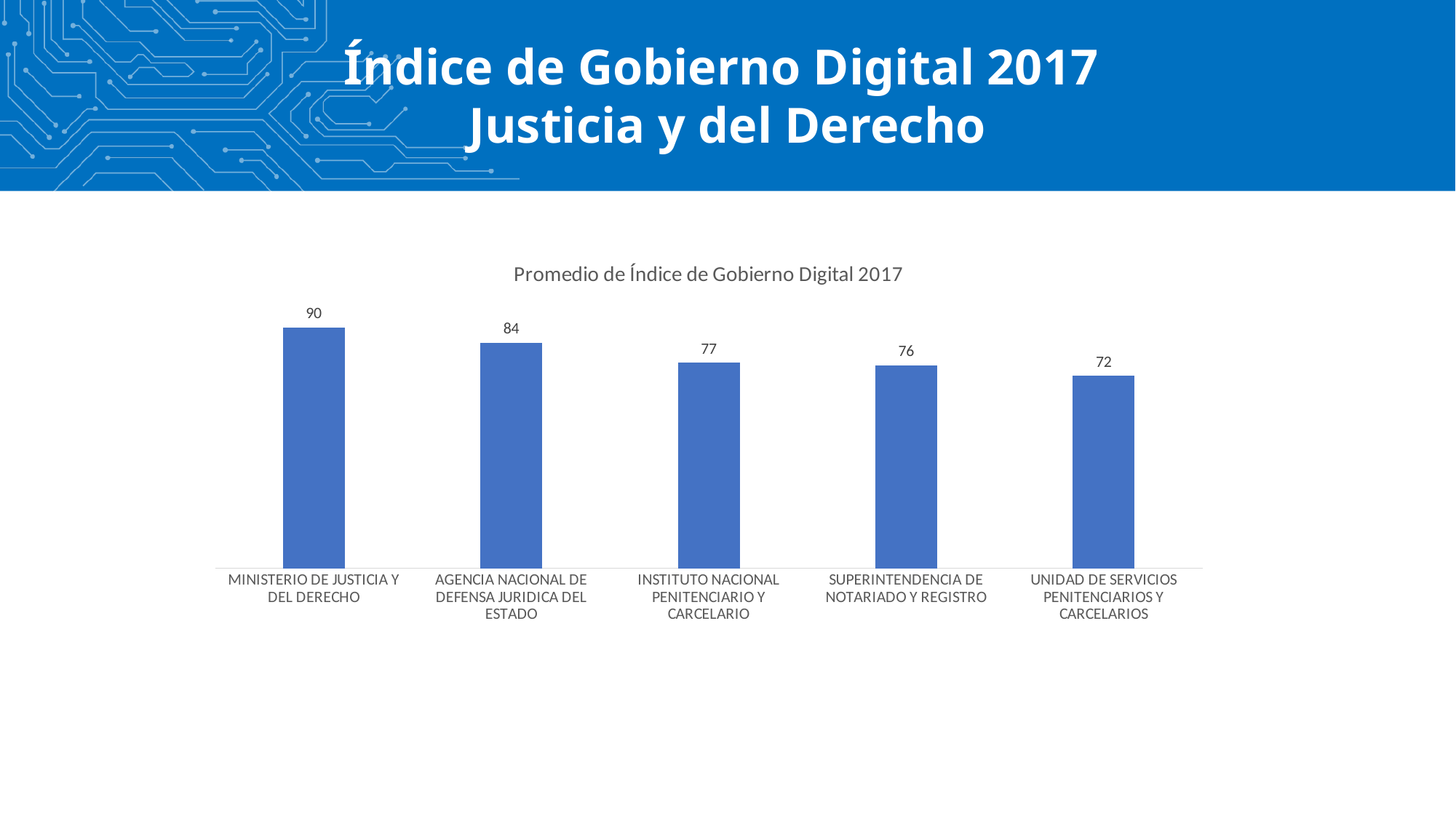
What kind of chart is shown on the slide? Bar chart Which is larger, the value for AGENCIA NACIONAL DE DEFENSA JURIDICA DEL ESTADO or the value for INSTITUTO NACIONAL PENITENCIARIO Y CARCELARIO? AGENCIA NACIONAL DE DEFENSA JURIDICA DEL ESTADO What is the value for AGENCIA NACIONAL DE DEFENSA JURIDICA DEL ESTADO? 84 How many categories are shown in the chart? 5 What is the difference between the values for MINISTERIO DE JUSTICIA Y DEL DERECHO and UNIDAD DE SERVICIOS PENITENCIARIOS Y CARCELARIOS? 18 What is the value for MINISTERIO DE JUSTICIA Y DEL DERECHO? 90 Which category has the highest value? MINISTERIO DE JUSTICIA Y DEL DERECHO What is the title of the chart? Promedio de Índice de Gobierno Digital 2017 What is the value for UNIDAD DE SERVICIOS PENITENCIARIOS Y CARCELARIOS? 72 Which category has the lowest value? UNIDAD DE SERVICIOS PENITENCIARIOS Y CARCELARIOS What is the value for SUPERINTENDENCIA DE NOTARIADO Y REGISTRO? 76 What is the value for INSTITUTO NACIONAL PENITENCIARIO Y CARCELARIO? 77